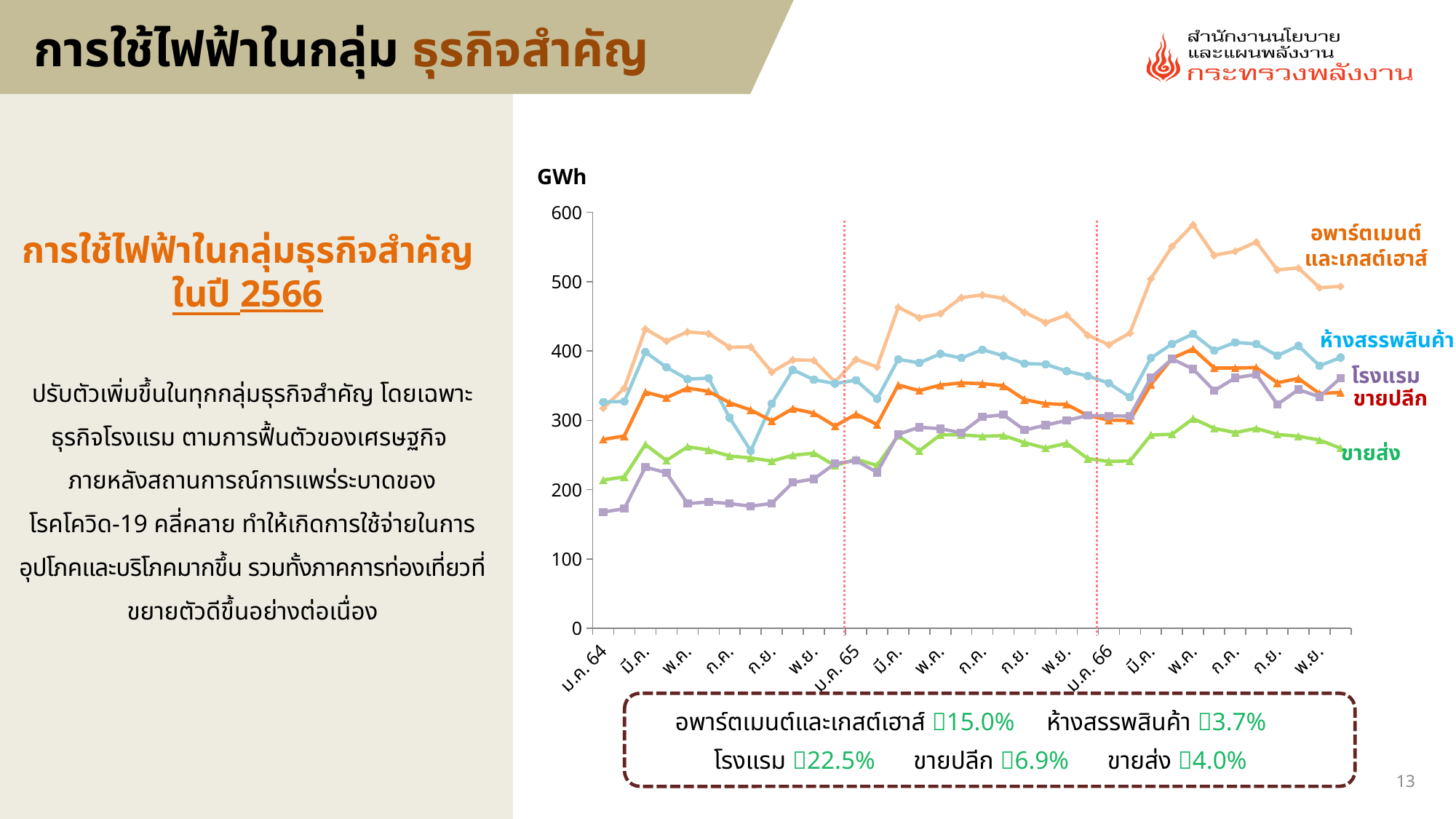
What unit is shown on the y axis of the chart? GWh Does the โรงแรม line rise or fall from ม.ค. 64 to พ.ย. 66? rise Is the peak value of อพาร์ตเมนต์และเกสต์เฮาส์ in 2566 greater or less than 500? greater According to the box below the chart, what is the percentage change shown for โรงแรม? 22.5% Is the value for ขายปลีก at ม.ค. 64 greater or less than 300? less Which series has the highest values across the whole chart? อพาร์ตเมนต์และเกสต์เฮาส์ Which series has the lowest value at ม.ค. 64? โรงแรม Is the value for โรงแรม at ม.ค. 64 greater or less than 200? less At พ.ย. 66, which is larger: ห้างสรรพสินค้า or ขายส่ง? ห้างสรรพสินค้า Which series has the lowest value at พ.ย. 66? ขายส่ง What kind of chart is shown on the slide? line chart How many series (lines) are plotted on the chart? 5